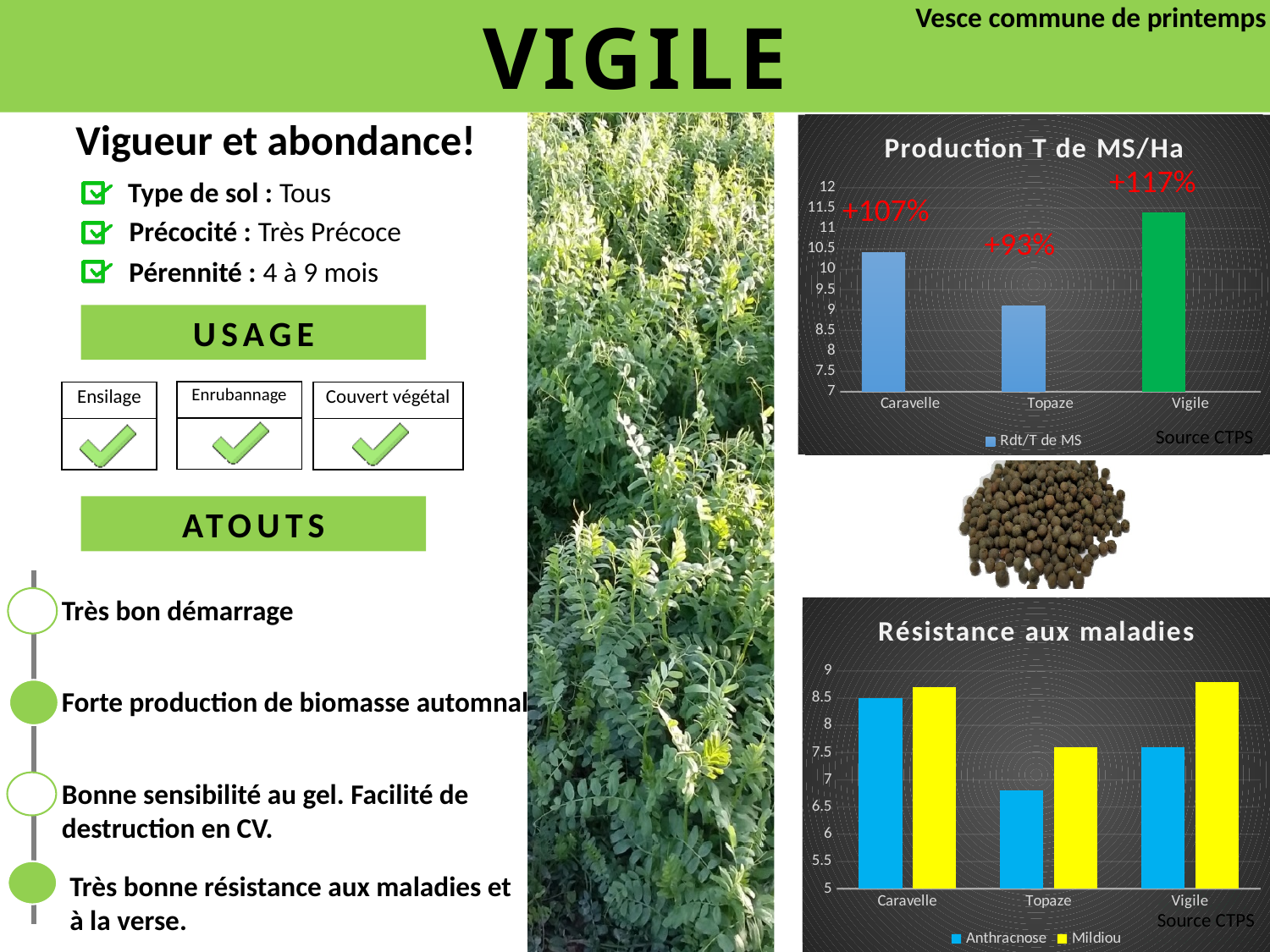
In the 'Production T de MS/Ha' chart, which category has the lowest value? Topaze In the 'Production T de MS/Ha' chart, is the value for Vigile greater or less than 11? greater In the 'Résistance aux maladies' chart, is the Mildiou value for Caravelle greater or less than 8? greater In the 'Production T de MS/Ha' chart, is the value for Topaze greater or less than 9.5? less In the 'Production T de MS/Ha' chart, what kind of chart is shown? bar chart In the 'Résistance aux maladies' chart, how many series does the legend list? 2 In the 'Production T de MS/Ha' chart, which category has the highest value? Vigile In the 'Résistance aux maladies' chart, which category has the lowest Anthracnose value? Topaze In the 'Résistance aux maladies' chart, which is larger for Vigile, Anthracnose or Mildiou? Mildiou In the 'Production T de MS/Ha' chart, what percentage annotation is shown above the Vigile bar? +117% In the 'Production T de MS/Ha' chart, how many categories are plotted? 3